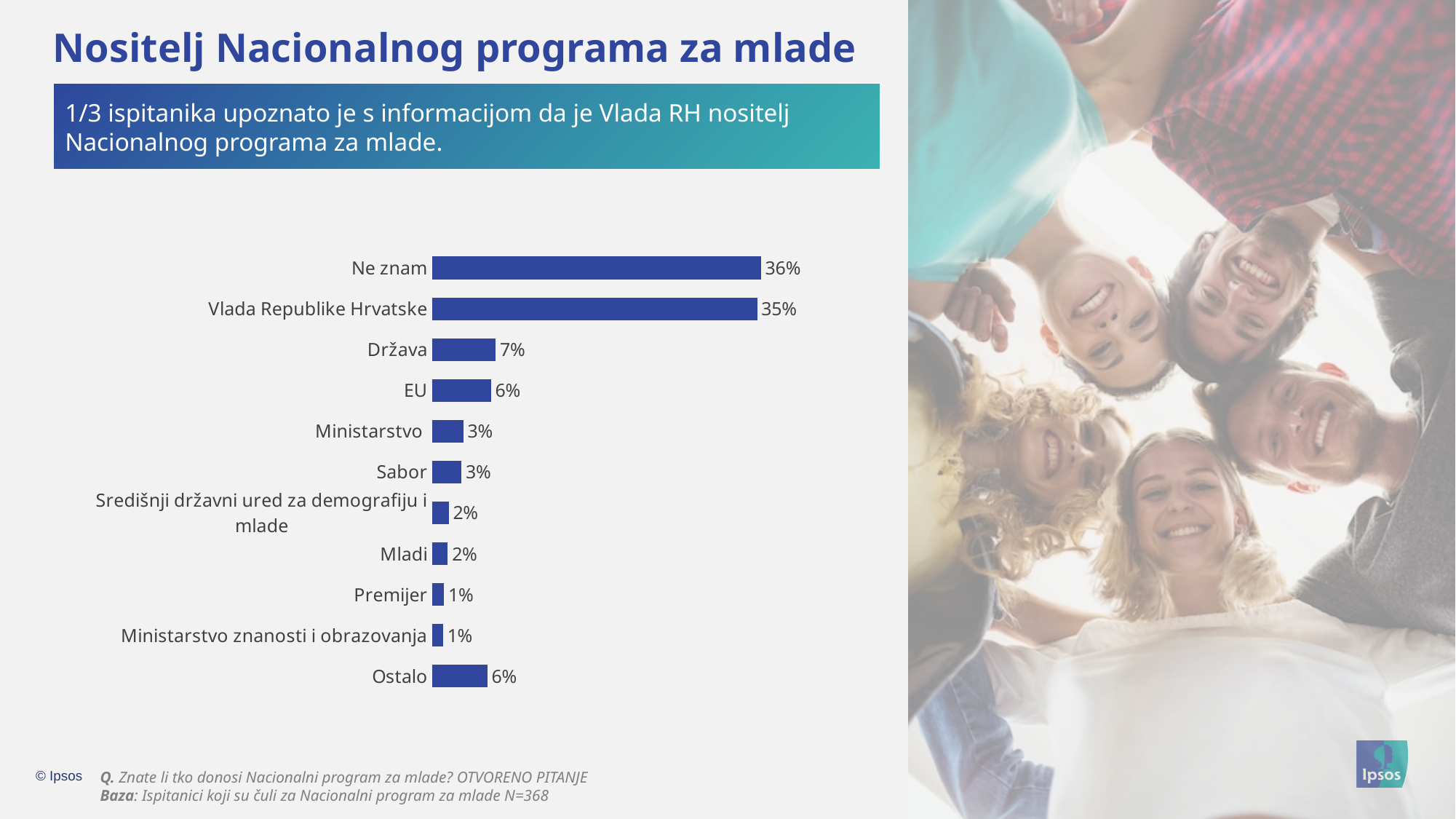
What is the difference between the values for Država and Ministarstvo? 4% What value is shown for Vlada Republike Hrvatske? 35% What value is shown for Država? 7% Which is larger, the value for Država or the value for Ostalo? Država What value is shown for Ostalo? 6% What is the title of the slide? Nositelj Nacionalnog programa za mlade What is the difference between the values for Ne znam and Vlada Republike Hrvatske? 1% How many categories are shown in the chart? 11 What kind of chart is shown on the slide? Bar chart Which category has the highest value? Ne znam Which is larger, the value for EU or the value for Sabor? EU What value is shown for Središnji državni ured za demografiju i mlade? 2%